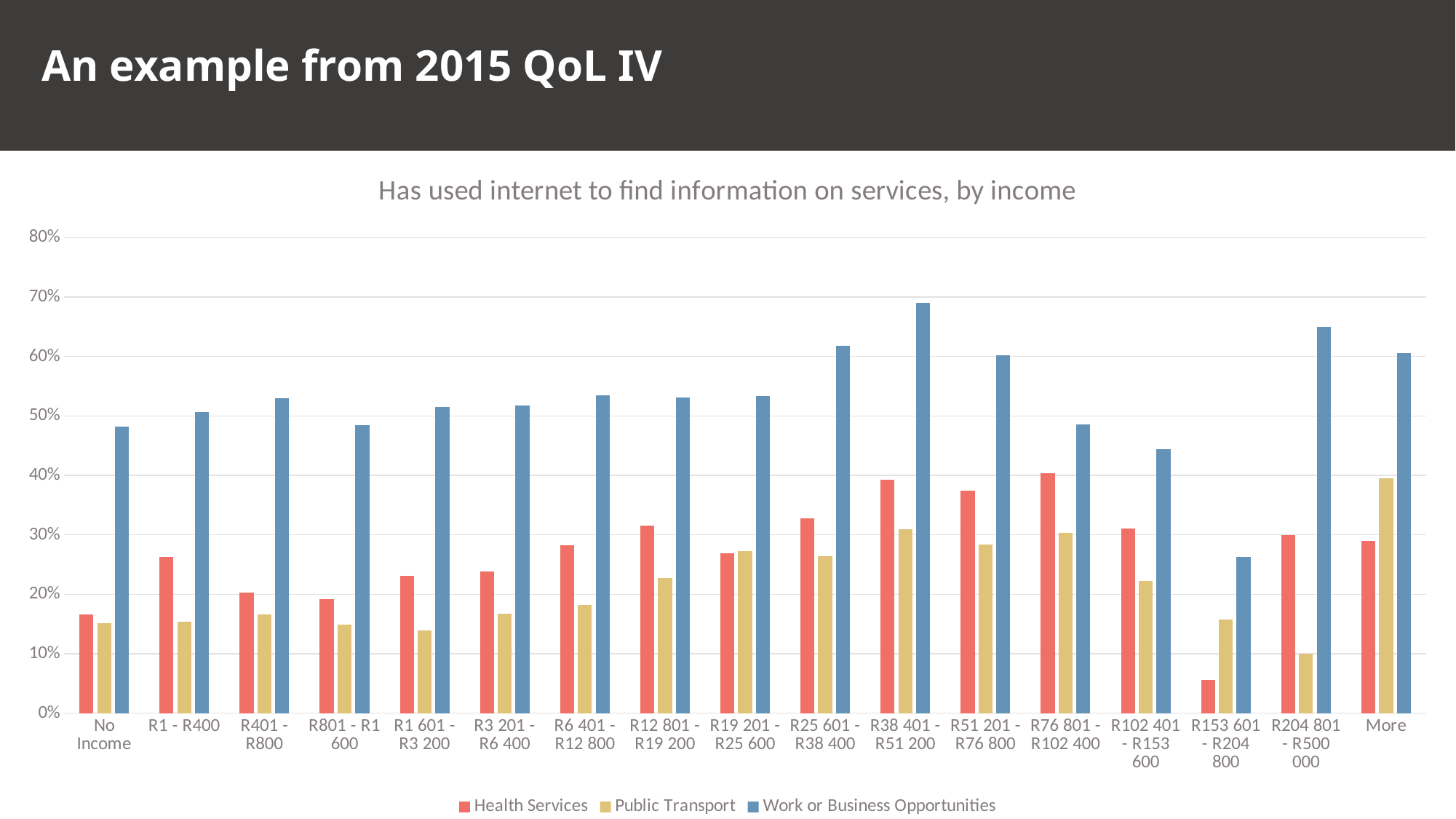
What is the title of the chart? Has used internet to find information on services, by income How many income categories are shown on the x axis? 17 How many series does the legend list? 3 What kind of chart is shown on the slide? bar chart For the More category, which is larger: Health Services or Public Transport? Public Transport For which income category is the Work or Business Opportunities value lowest? R153 601 - R204 800 For which income category is the Public Transport value highest? More Is the Work or Business Opportunities value for No Income greater or less than 50%? less For which income category is the Health Services value lowest? R153 601 - R204 800 For which income category is the Work or Business Opportunities value highest? R38 401 - R51 200 Which series is shown in blue? Work or Business Opportunities Is the Health Services value for R12 801 - R19 200 greater or less than 30%? greater